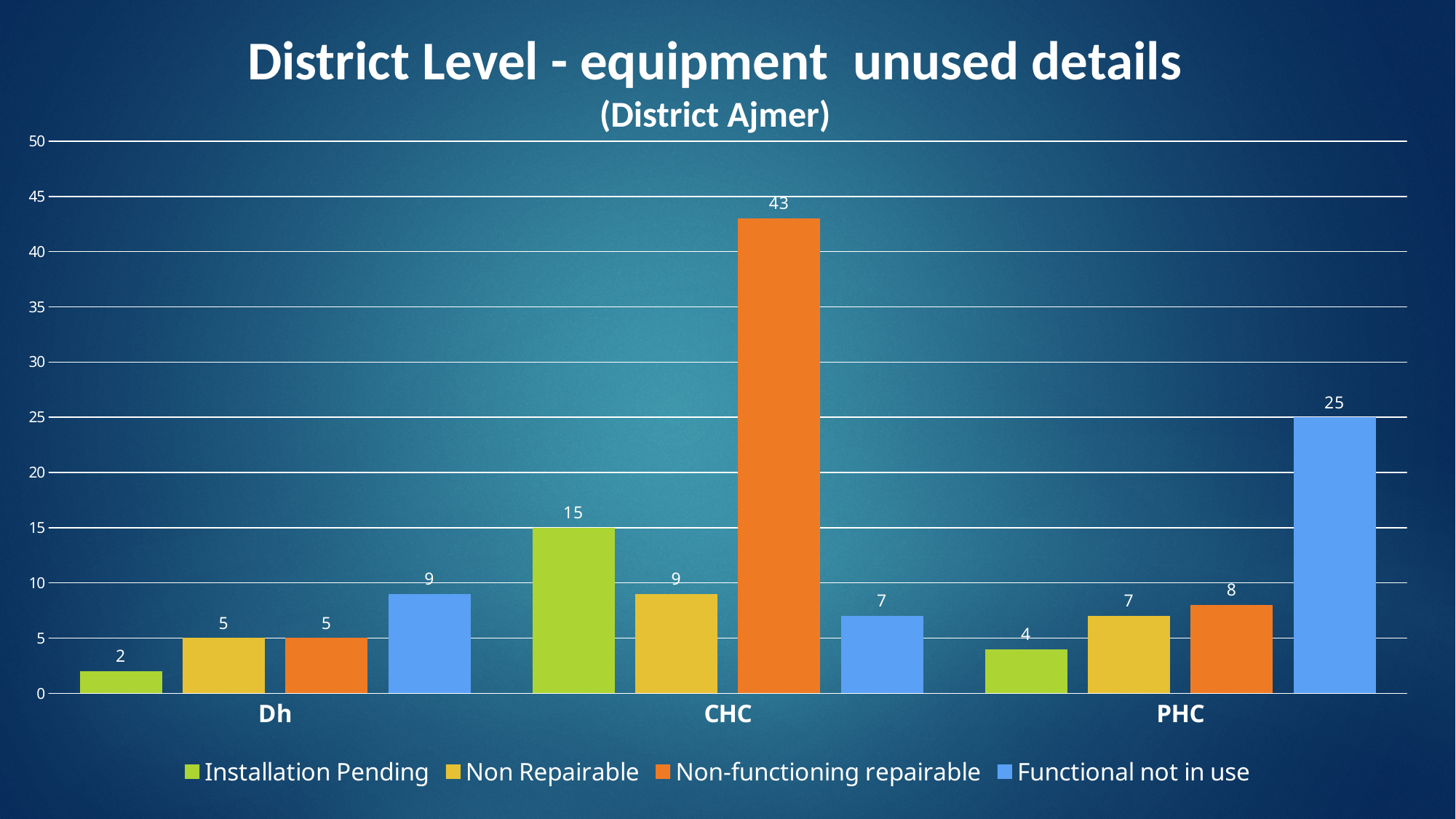
What kind of chart is shown on the slide? Bar chart Which district is named in the chart subtitle? District Ajmer How many series does the legend list? 4 What is the value for Installation Pending at Dh? 2 What is the value for Functional not in use at PHC? 25 What is the value for Non-functioning repairable at CHC? 43 How many categories are shown on the x axis? 3 What is the value for Non Repairable at PHC? 7 Which category has the lowest value for Functional not in use? CHC Which is larger: Functional not in use at Dh or Non Repairable at Dh? Functional not in use at Dh What is the difference between the Non-functioning repairable values for CHC and PHC? 35 Which category has the highest value for Installation Pending? CHC